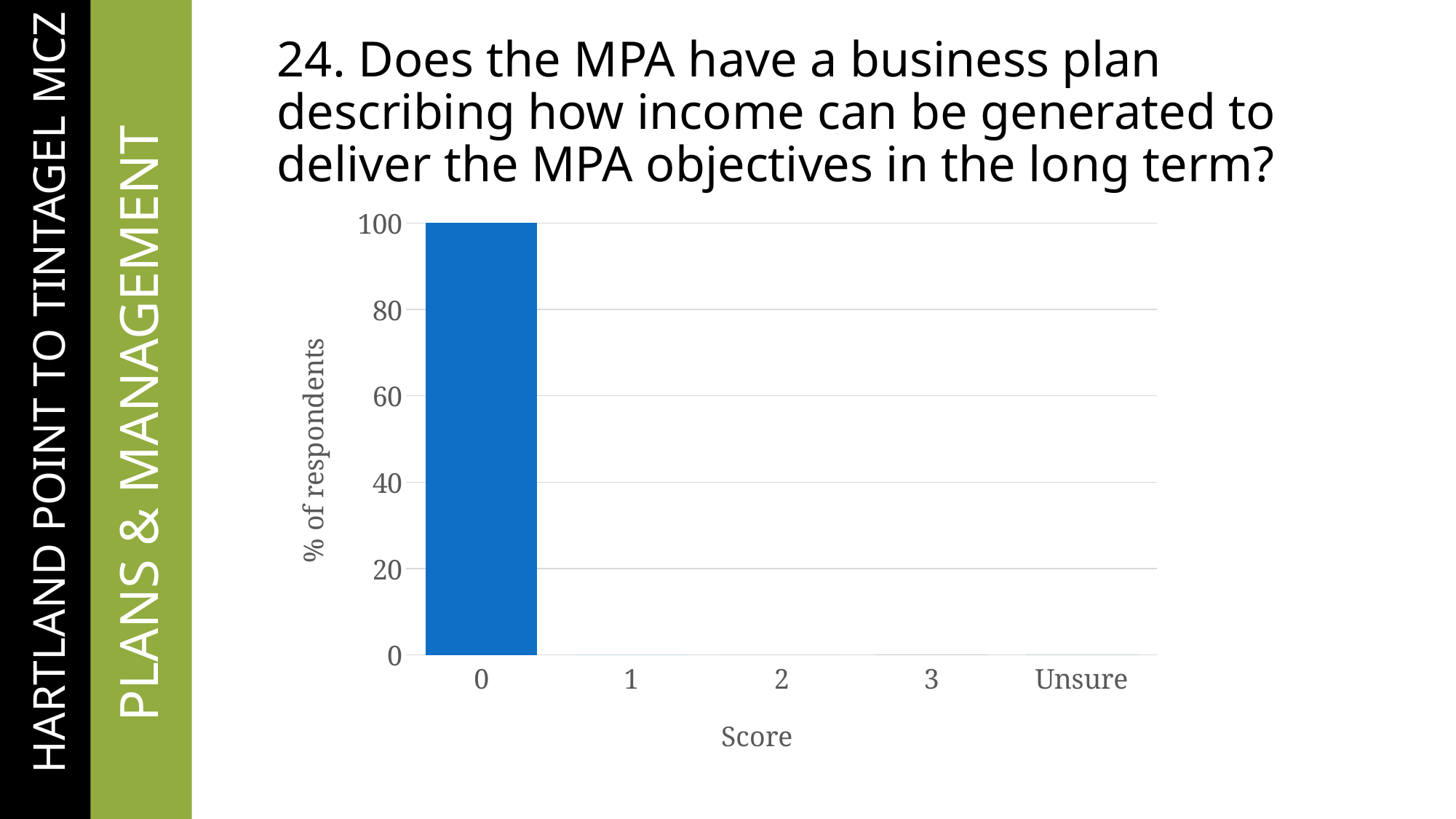
Is the value for score 2 greater or less than 20? less Which score category has the highest percentage of respondents? 0 Which is larger, the value for score 0 or the value for Unsure? 0 What is the value for score 0? 100 What is the value for score 3? 0 Is the value for score 0 greater or less than 80? greater What is the label of the y axis? % of respondents What is the label of the x axis? Score How many score categories are shown on the x axis? 5 What is the difference between the value for score 0 and the value for score 1? 100 What kind of chart is shown on the slide? bar chart